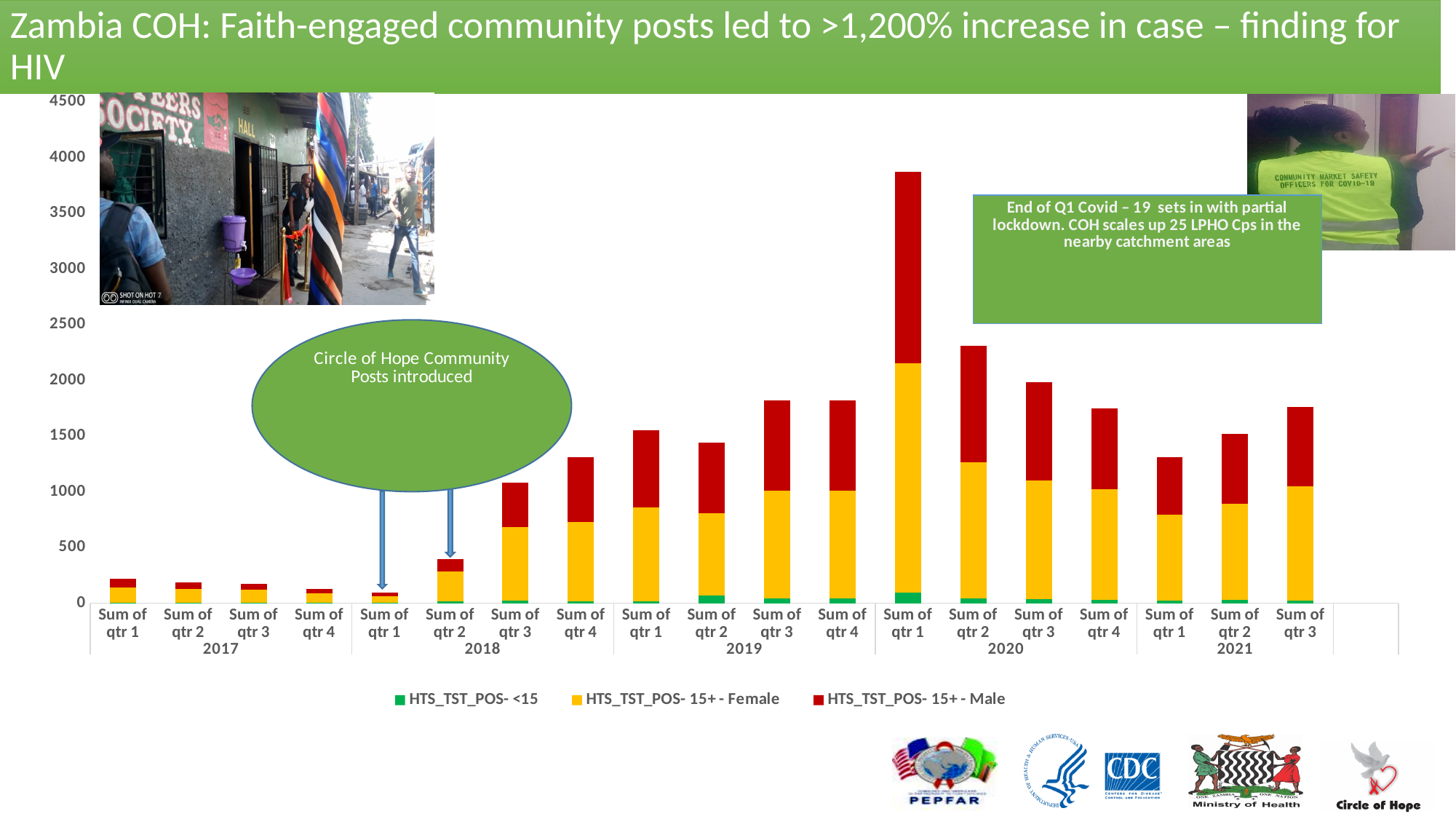
Which quarter has the highest total bar in the chart? Sum of qtr 1, 2020 What kind of chart is shown on the slide? Stacked bar chart Is the total value for Sum of qtr 1 in 2018 greater or less than 500? less According to the callout on the chart, what was introduced around qtr 2 of 2018? Circle of Hope Community Posts Is the total value for Sum of qtr 1 in 2020 greater or less than 3500? greater Do the total bar values rise or fall across the four quarters of 2018? Rise Is the total value for Sum of qtr 2 in 2020 greater or less than 2000? greater Which quarter has the lowest total bar in the chart? Sum of qtr 1, 2018 Which series is shown in red in the chart legend? HTS_TST_POS- 15+ - Male How many series does the chart legend list? 3 Which has the larger total bar: Sum of qtr 2 in 2020 or Sum of qtr 4 in 2020? Sum of qtr 2, 2020 How many quarterly bars are plotted in the chart? 19